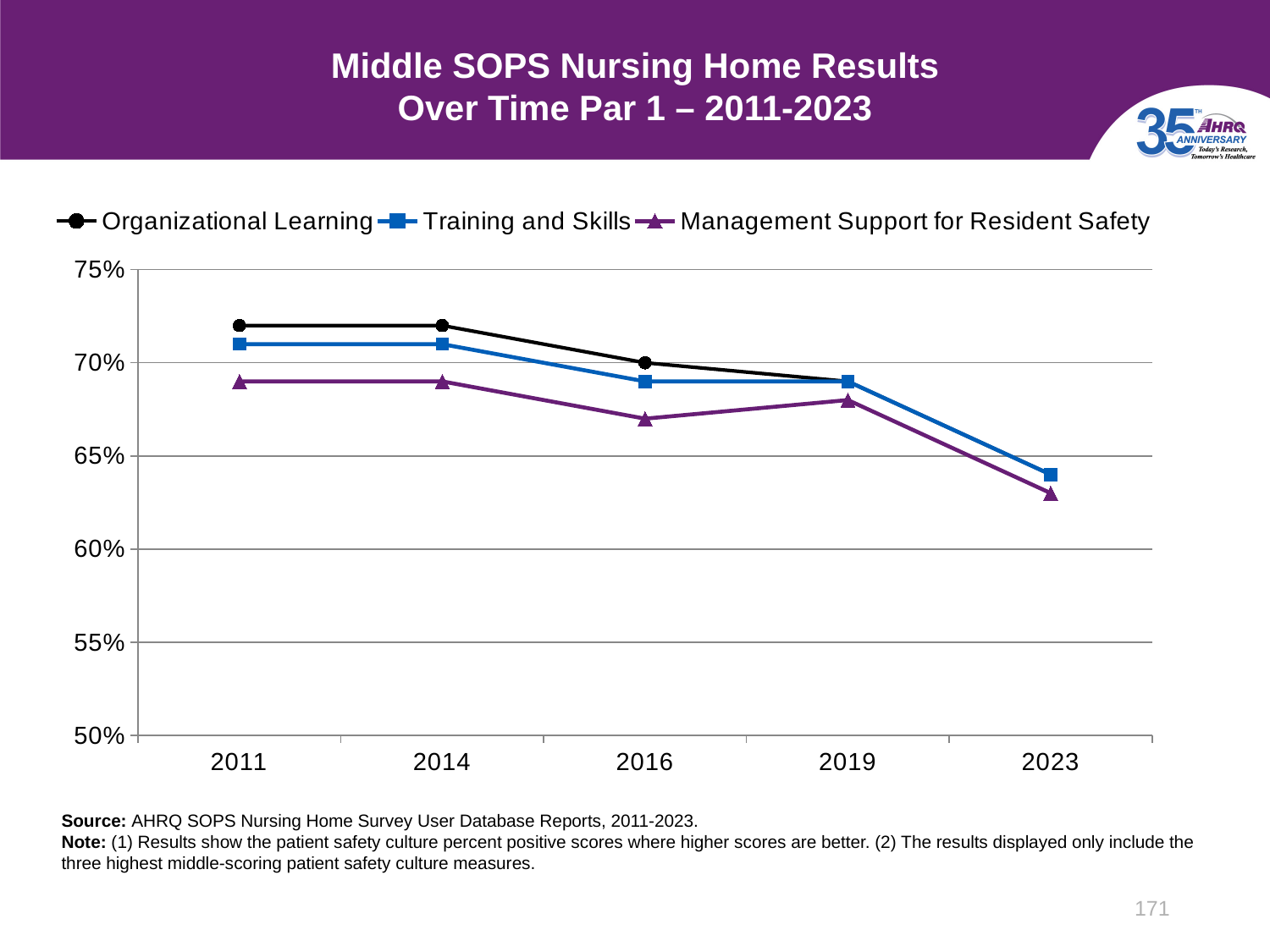
Do the values for Training and Skills rise or fall from 2011 to 2023? fall How many years are shown on the x axis? 5 In 2016, which is higher: Training and Skills or Management Support for Resident Safety? Training and Skills How many series does the legend list? 3 Which series has the lowest value in 2016? Management Support for Resident Safety Is the value for Training and Skills in 2023 greater or less than 65%? less Is the value for Management Support for Resident Safety in 2023 greater or less than 65%? less Is the value for Organizational Learning in 2011 greater or less than 70%? greater What is the title of the slide's chart? Middle SOPS Nursing Home Results Over Time Par 1 – 2011-2023 What kind of chart is shown on the slide? line chart Which series has the highest value in 2011? Organizational Learning